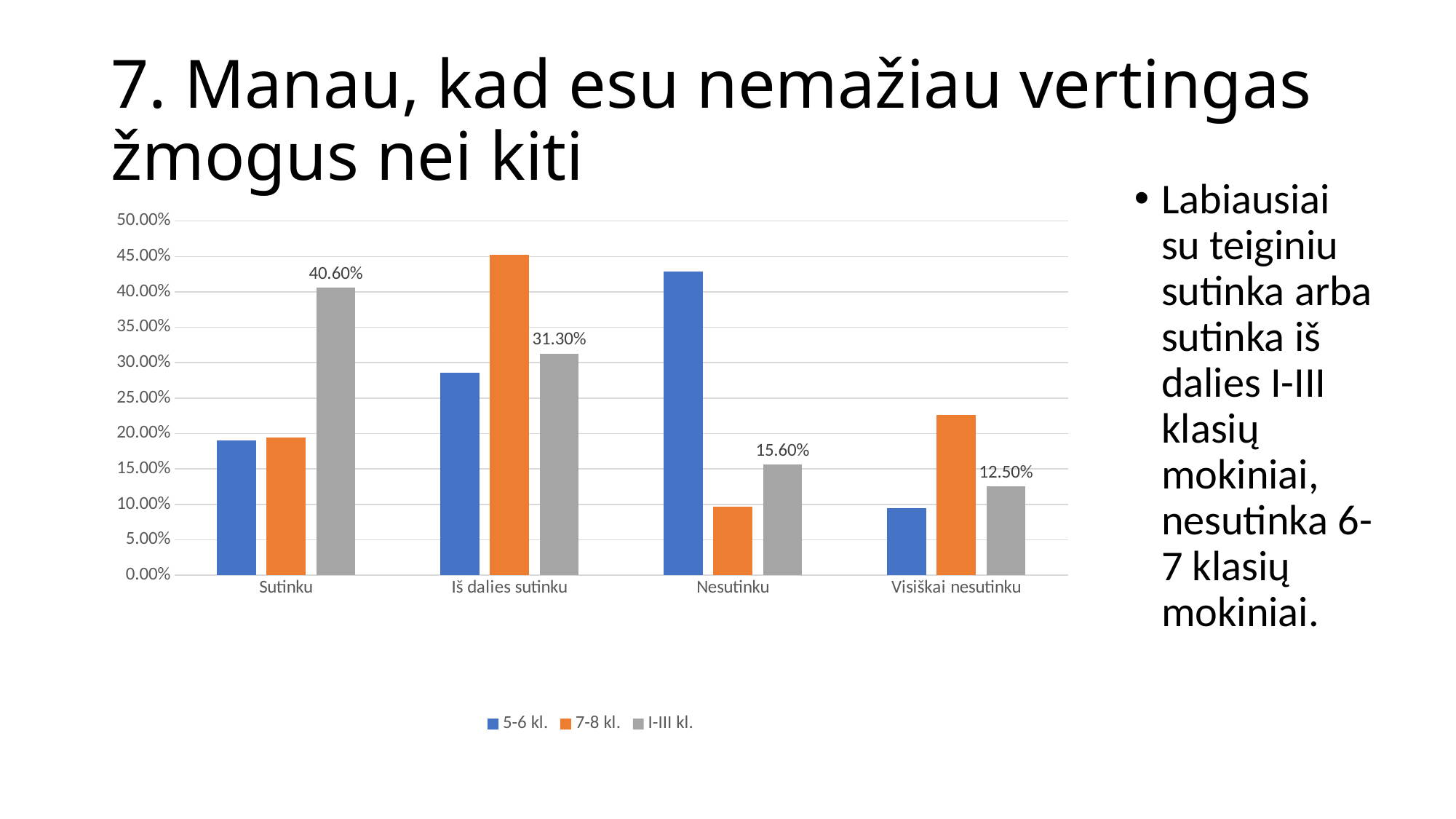
What is the value for I-III kl. in the Nesutinku category? 15.60% How many series does the legend list? 3 In which category is the I-III kl. value lowest? Visiškai nesutinku In which category is the I-III kl. value highest? Sutinku What is the value for I-III kl. in the Visiškai nesutinku category? 12.50% Is the value for 7-8 kl. in the Iš dalies sutinku category greater or less than 40.00%? greater What is the value for I-III kl. in the Sutinku category? 40.60% How many categories are shown on the x axis? 4 Which series has the larger value in the Nesutinku category, 5-6 kl. or 7-8 kl.? 5-6 kl. What kind of chart is shown on the slide? Bar chart What is the value for I-III kl. in the Iš dalies sutinku category? 31.30% What is the difference between the I-III kl. values for Sutinku and Iš dalies sutinku? 9.30%